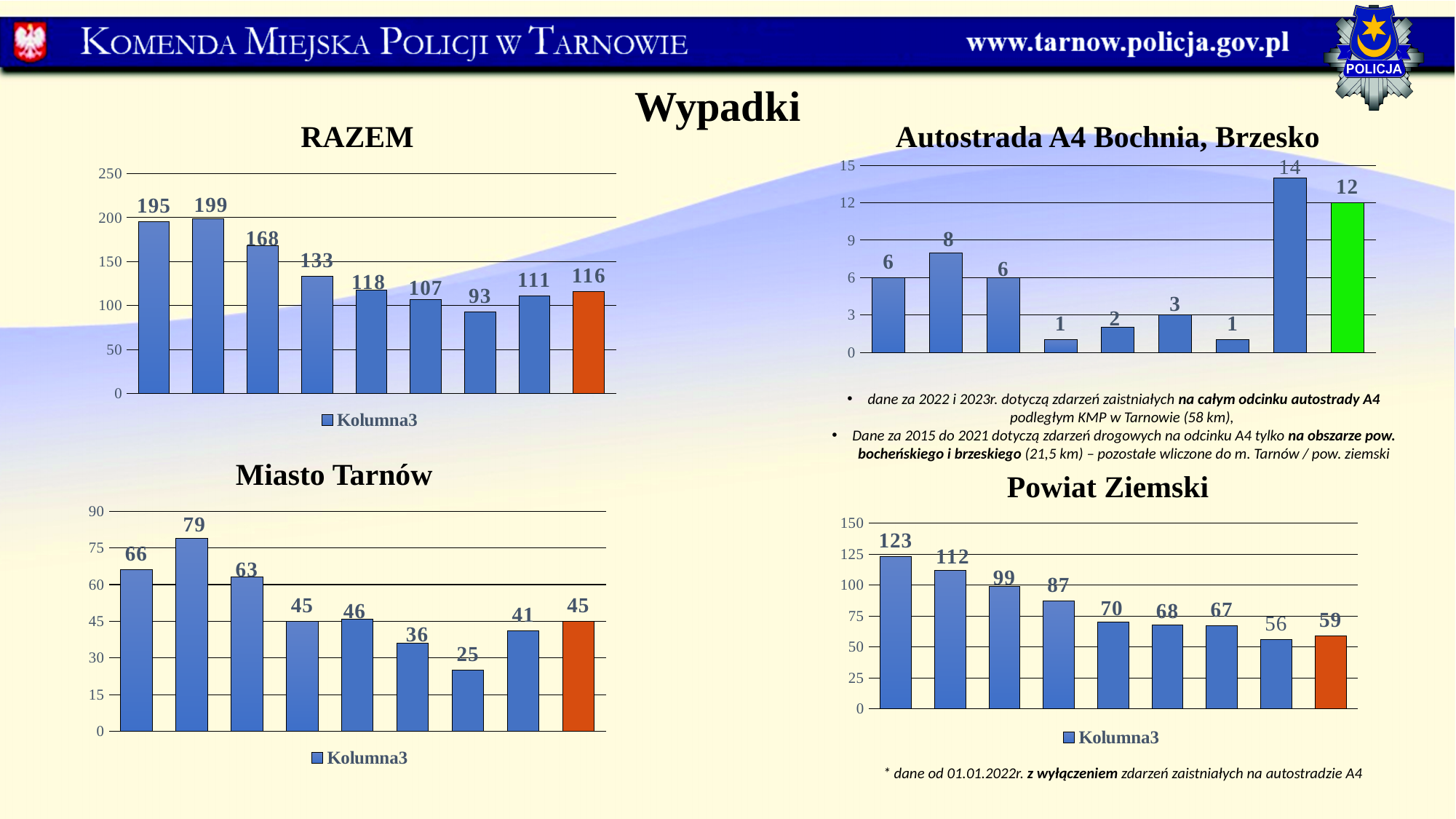
In the Autostrada A4 Bochnia, Brzesko chart, what is the value of the last (green) bar? 12 In the RAZEM chart, what is the highest value shown? 199 What legend entry is shown under the RAZEM chart? Kolumna3 In the Autostrada A4 Bochnia, Brzesko chart, what is the highest value shown? 14 In the Miasto Tarnów chart, what is the difference between the highest value and the lowest value? 54 How many charts are on the slide? 4 In the RAZEM chart, what is the value of the last (orange) bar? 116 In the RAZEM chart, how many bars are plotted? 9 In the RAZEM chart, what is the lowest value shown? 93 In the Miasto Tarnów chart, what is the value of the first bar? 66 In the Powiat Ziemski chart, what is the lowest value shown? 56 In the Powiat Ziemski chart, which is larger, the first bar or the last bar? the first bar (123)